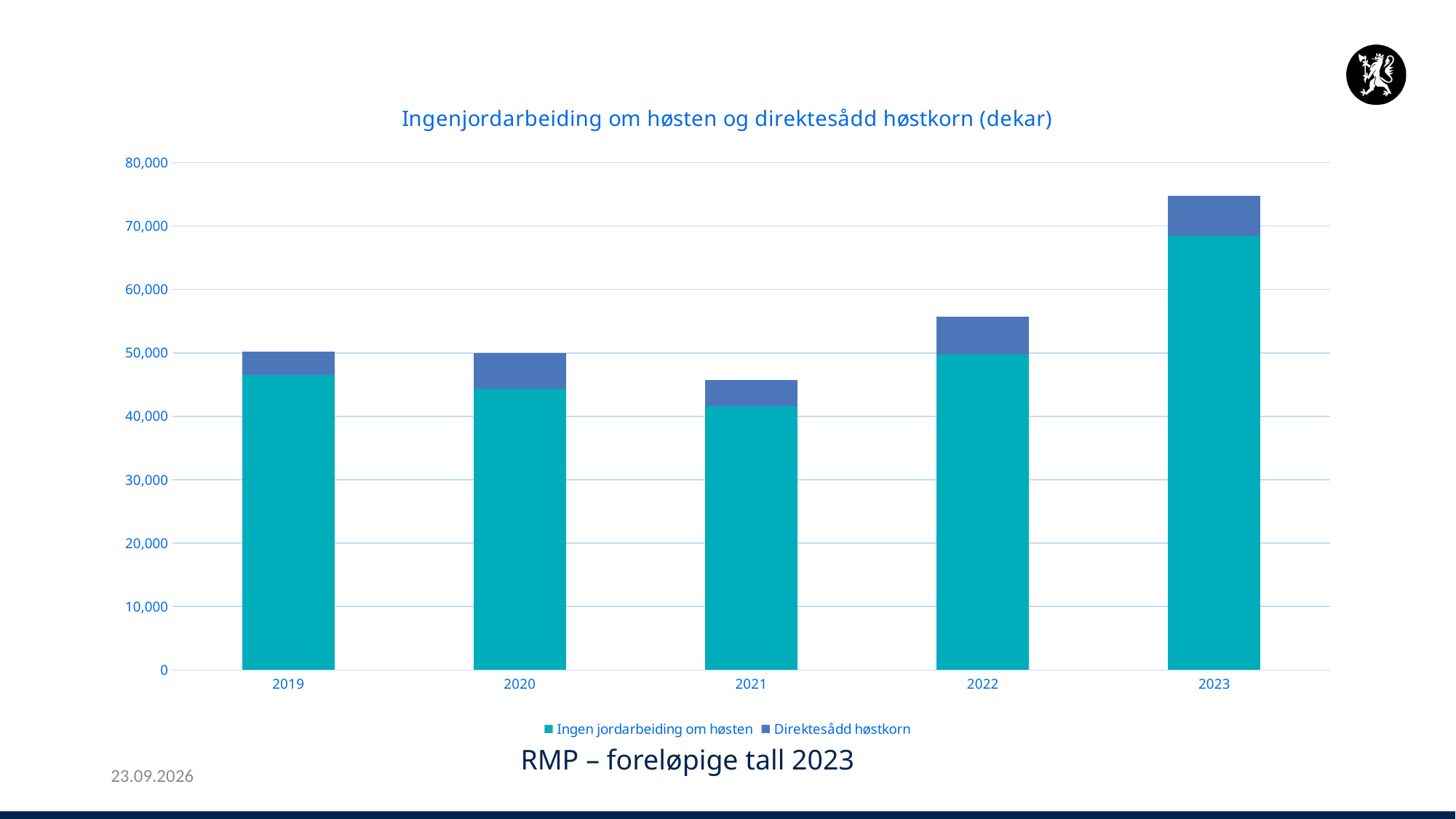
What kind of chart is shown on the slide? Stacked bar chart How many series does the chart's legend list? 2 Is the total stacked value for 2022 greater or less than 50,000? greater Is the total stacked value for 2023 greater or less than 70,000? greater How many years are shown on the x axis of the chart? 5 Which year has the lowest total stacked bar? 2021 Which year has the highest total stacked bar? 2023 Do the total stacked values rise or fall from 2021 to 2023? rise What is the title of the chart? Ingenjordarbeiding om høsten og direktesådd høstkorn (dekar) Is the total stacked value for 2021 greater or less than 50,000? less Which year has the larger total stacked bar, 2022 or 2023? 2023